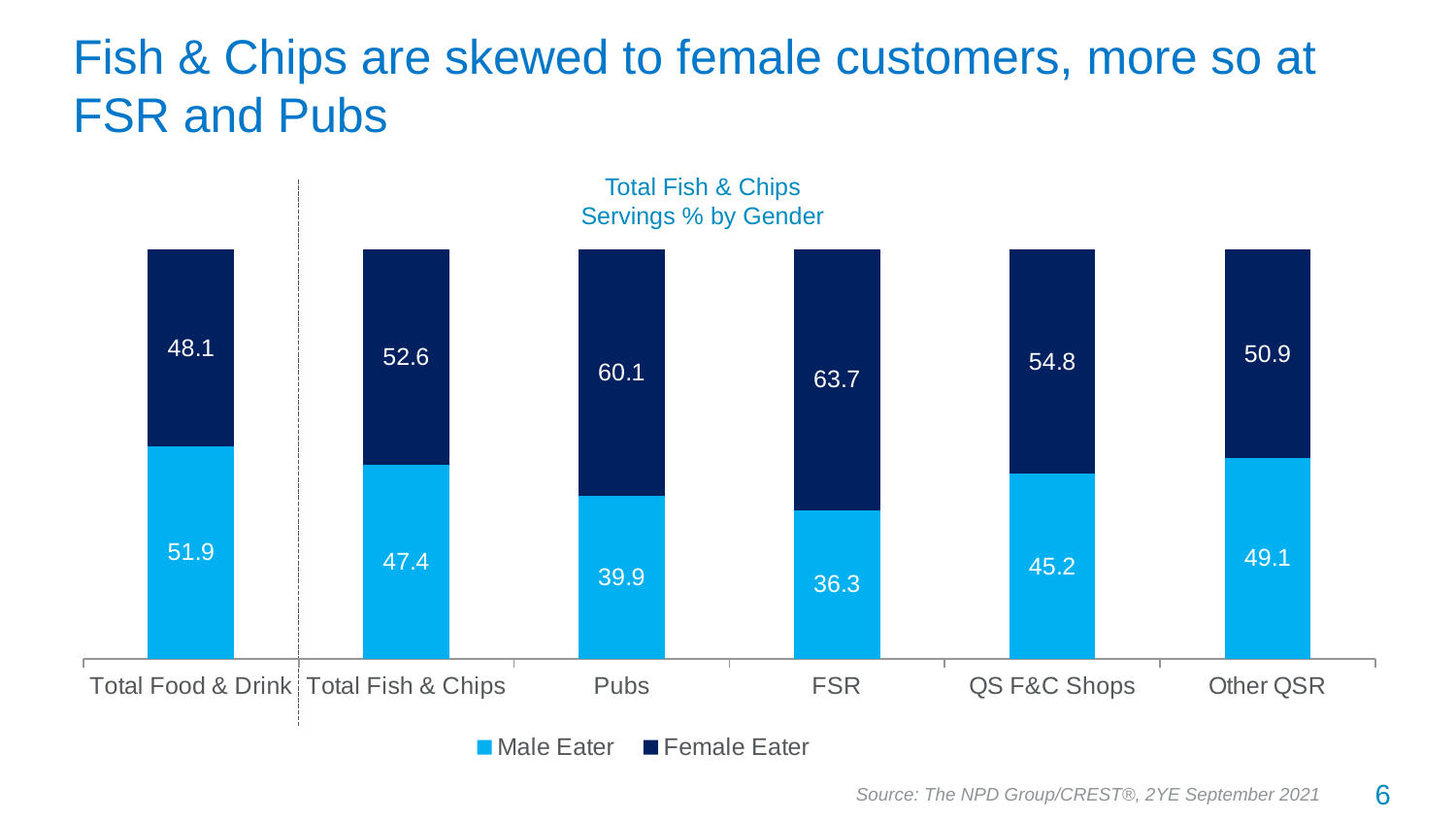
What is the Male Eater value for Total Food & Drink? 51.9 What is the Female Eater value for FSR? 63.7 What is the Male Eater value for Pubs? 39.9 What kind of chart is shown on the slide? Stacked bar chart How many categories are shown on the x axis? 6 What is the title of the chart? Total Fish & Chips Servings % by Gender What is the total of the stacked bar for Total Fish & Chips? 100 Which category has the lowest Male Eater value? FSR Which is larger, the Male Eater value for QS F&C Shops or for Other QSR? Other QSR How many series does the legend list? 2 Which category has the highest Female Eater value? FSR What is the difference between the Female Eater and Male Eater values for Pubs? 20.2